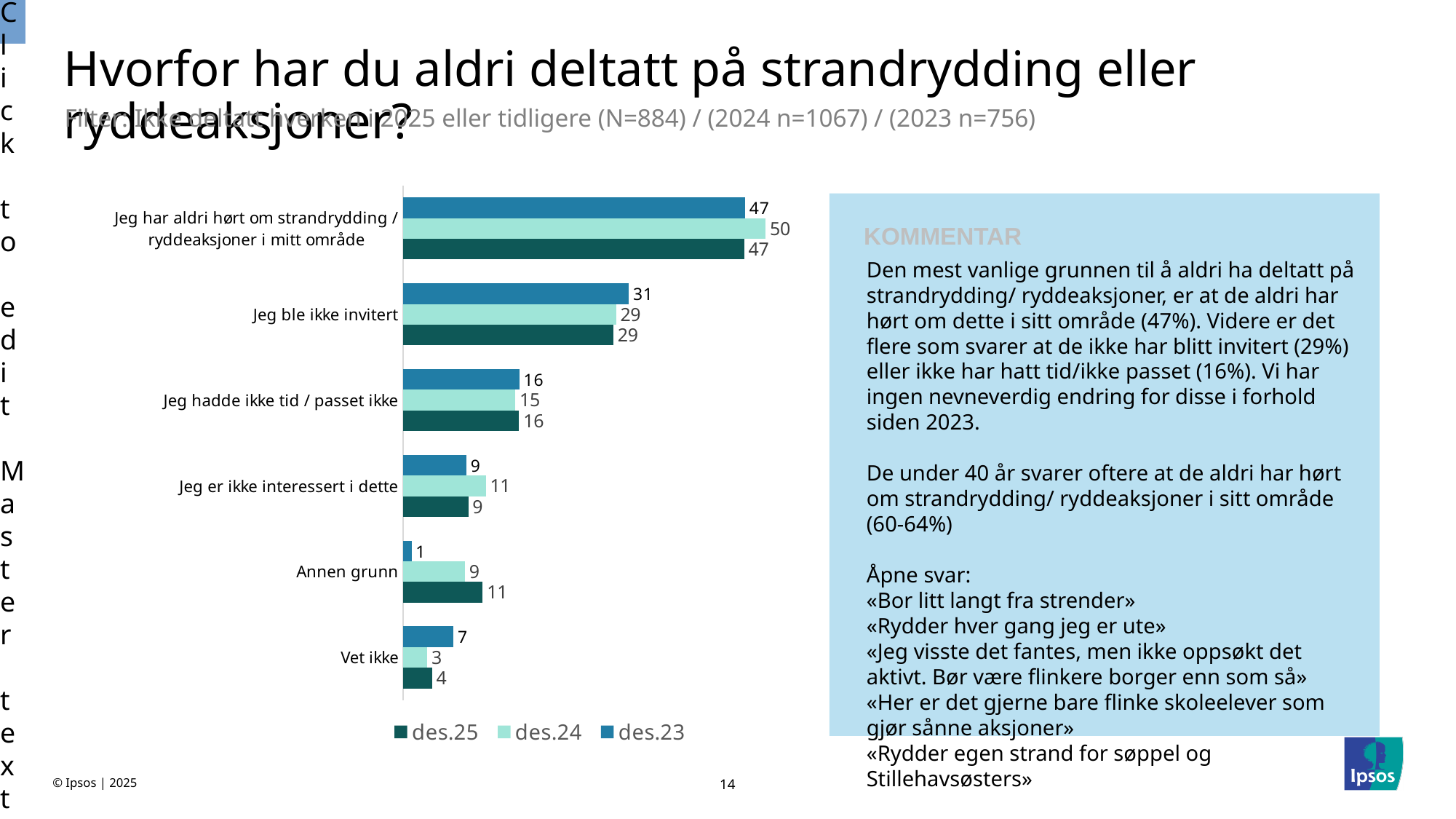
How many categories are shown on the chart? 6 What is the des.24 value for "Jeg har aldri hørt om strandrydding / ryddeaksjoner i mitt område"? 50 Which series is shown in the lightest colour in the legend? des.24 Which category has the lowest des.24 value? Vet ikke What is the des.23 value for "Annen grunn"? 1 What is the des.25 value for "Jeg hadde ikke tid / passet ikke"? 16 How many series does the legend list? 3 Which category has the highest des.25 value? Jeg har aldri hørt om strandrydding / ryddeaksjoner i mitt område Which is larger for "Vet ikke": the des.23 value or the des.25 value? des.23 What is the des.25 value for "Jeg ble ikke invitert"? 29 What is the difference between the des.23 and des.24 values for "Jeg ble ikke invitert"? 2 What kind of chart is shown on the slide? Bar chart